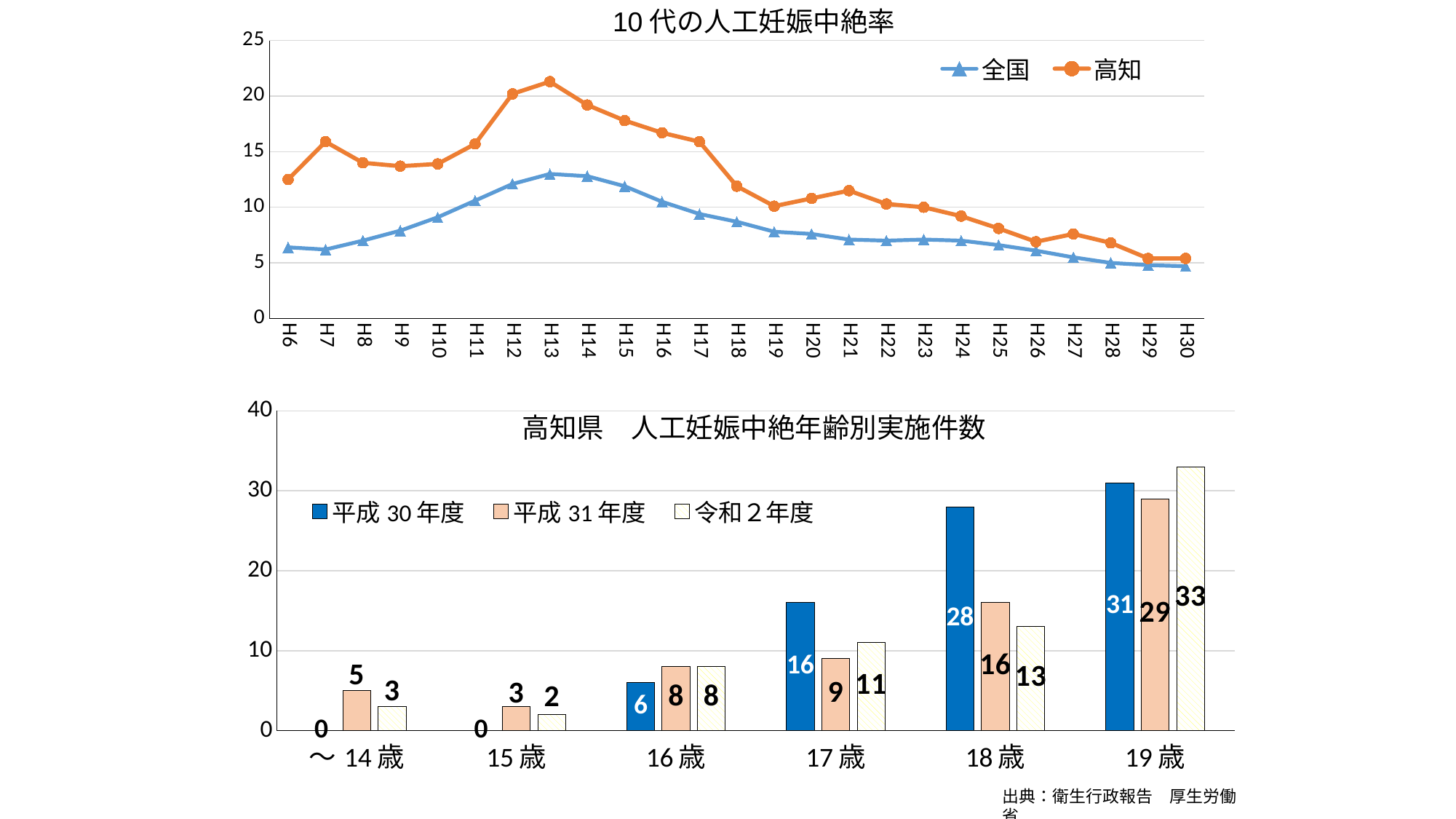
In the bottom chart titled 高知県 人工妊娠中絶年齢別実施件数, what is the value for 17歳 in 平成31年度? 9 In the top chart titled 10代の人工妊娠中絶率, how many years are plotted along the x axis? 25 In the top chart titled 10代の人工妊娠中絶率, what kind of chart is it? line chart In the top chart titled 10代の人工妊娠中絶率, is the value for 高知 at H13 greater or less than 20? greater In the bottom chart titled 高知県 人工妊娠中絶年齢別実施件数, which age group has the highest value in 平成30年度? 19歳 In the bottom chart titled 高知県 人工妊娠中絶年齢別実施件数, how many series does the legend list? 3 In the bottom chart titled 高知県 人工妊娠中絶年齢別実施件数, what is the difference between the 平成30年度 and 令和2年度 values for 18歳? 15 In the top chart titled 10代の人工妊娠中絶率, do the 高知 values rise or fall from H13 to H30? fall In the top chart titled 10代の人工妊娠中絶率, in which year does the 高知 series reach its highest value? H13 In the top chart titled 10代の人工妊娠中絶率, how many series does the legend list? 2 In the bottom chart titled 高知県 人工妊娠中絶年齢別実施件数, what is the value for 19歳 in 令和2年度? 33